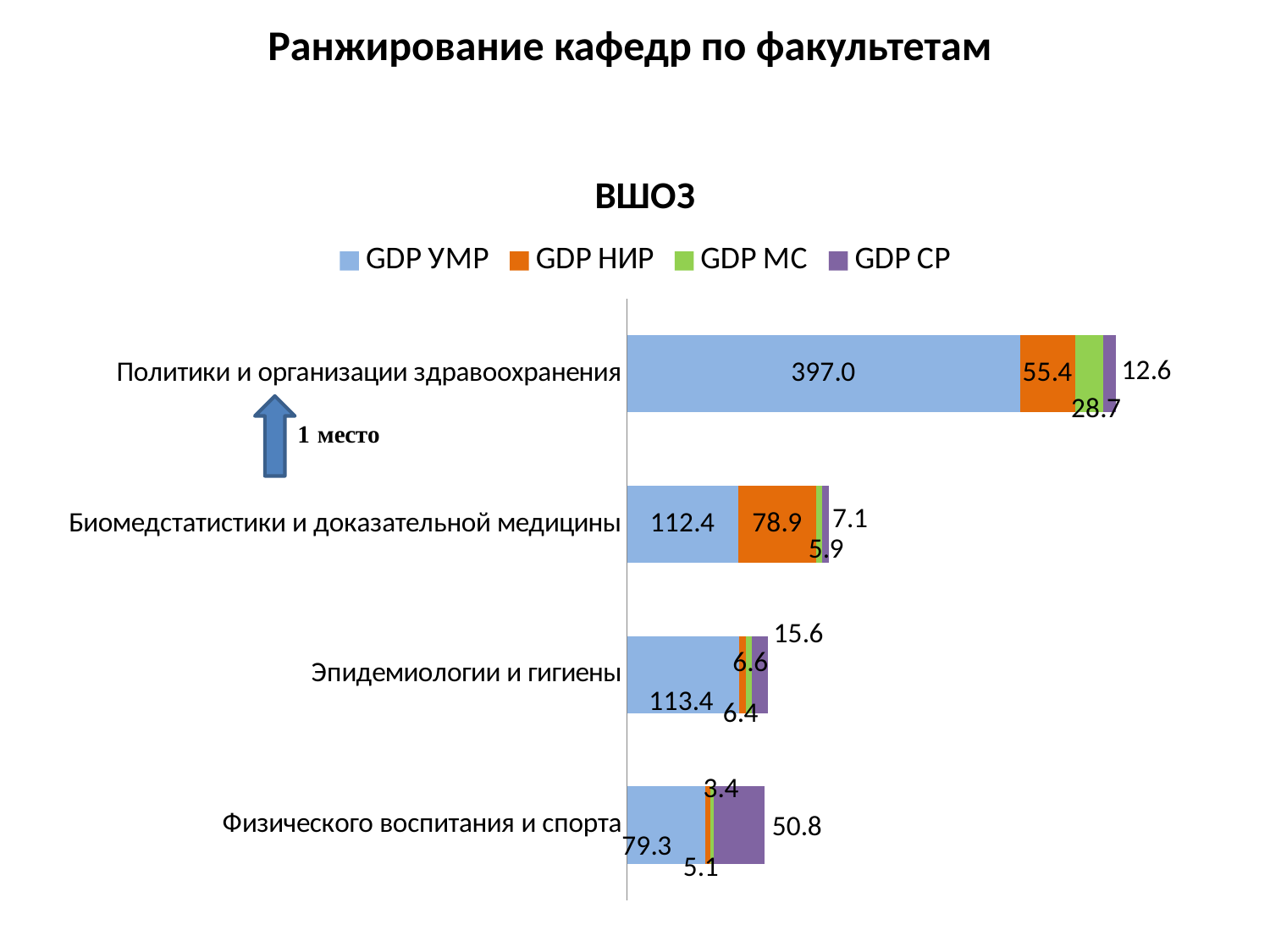
What is the GDP МС value for Политики и организации здравоохранения? 28.7 What kind of chart is shown on the slide? Stacked bar chart How many series does the legend of the ВШОЗ chart list? 4 How many departments (categories) are plotted in the ВШОЗ chart? 4 What is the total of the stacked bar for Политики и организации здравоохранения? 493.7 What is the GDP НИР value for Биомедстатистики и доказательной медицины? 78.9 What is the difference between the GDP УМР values of Эпидемиологии и гигиены and Биомедстатистики и доказательной медицины? 1.0 Which department has the highest GDP УМР value? Политики и организации здравоохранения What is the GDP СР value for Физического воспитания и спорта? 50.8 What is the GDP УМР value for Политики и организации здравоохранения? 397.0 Which is larger: the GDP СР value for Эпидемиологии и гигиены or for Физического воспитания и спорта? Физического воспитания и спорта Which department has the lowest GDP УМР value? Физического воспитания и спорта